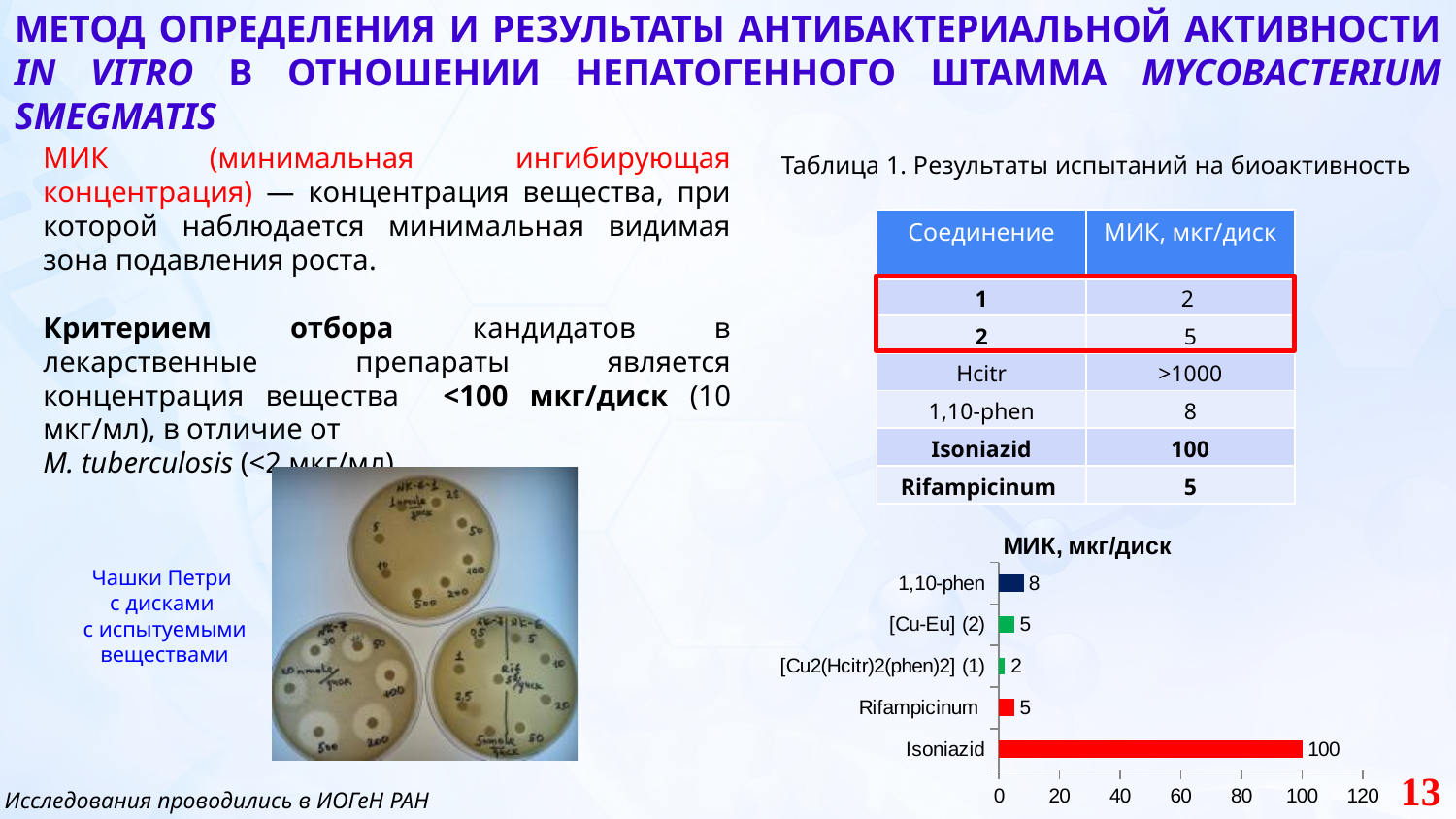
Which category has the highest value in the chart? Isoniazid Which category has the lowest value in the chart? [Cu2(Hcitr)2(phen)2] (1) How many categories are shown in the chart? 5 What is the title of the chart? МИК, мкг/диск What is the value for [Cu2(Hcitr)2(phen)2] (1) in the chart? 2 Which is larger, the value for 1,10-phen or the value for [Cu-Eu] (2)? 1,10-phen What is the value for Isoniazid in the chart? 100 What is the value for Rifampicinum in the chart? 5 What kind of chart is shown on the slide? bar chart What is the value for 1,10-phen in the chart? 8 What is the difference between the values for Isoniazid and 1,10-phen? 92 Is the value for Isoniazid greater or less than 80? greater